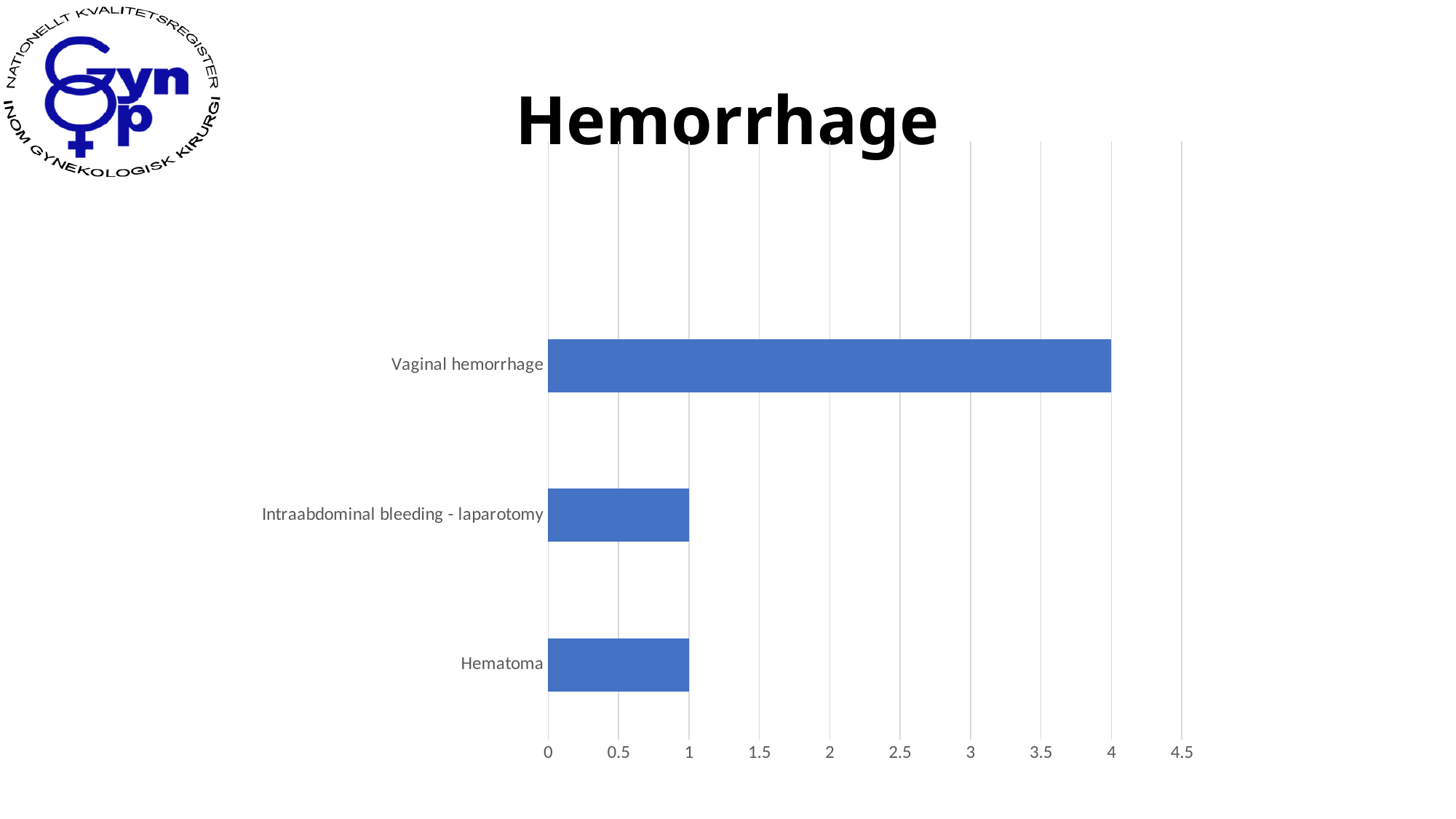
What is the value for Vaginal hemorrhage? 4 Is the value for Vaginal hemorrhage greater or less than 3? greater What is the title of the slide? Hemorrhage What is the difference between the values for Vaginal hemorrhage and Hematoma? 3 What is the value for Intraabdominal bleeding - laparotomy? 1 What is the value for Hematoma? 1 Which category has the highest value? Vaginal hemorrhage How many categories are shown in the chart? 3 What kind of chart is shown on the slide? bar chart Is the value for Hematoma greater or less than 2? less Which is larger, the value for Vaginal hemorrhage or the value for Intraabdominal bleeding - laparotomy? Vaginal hemorrhage What is the highest value shown on the x axis? 4.5